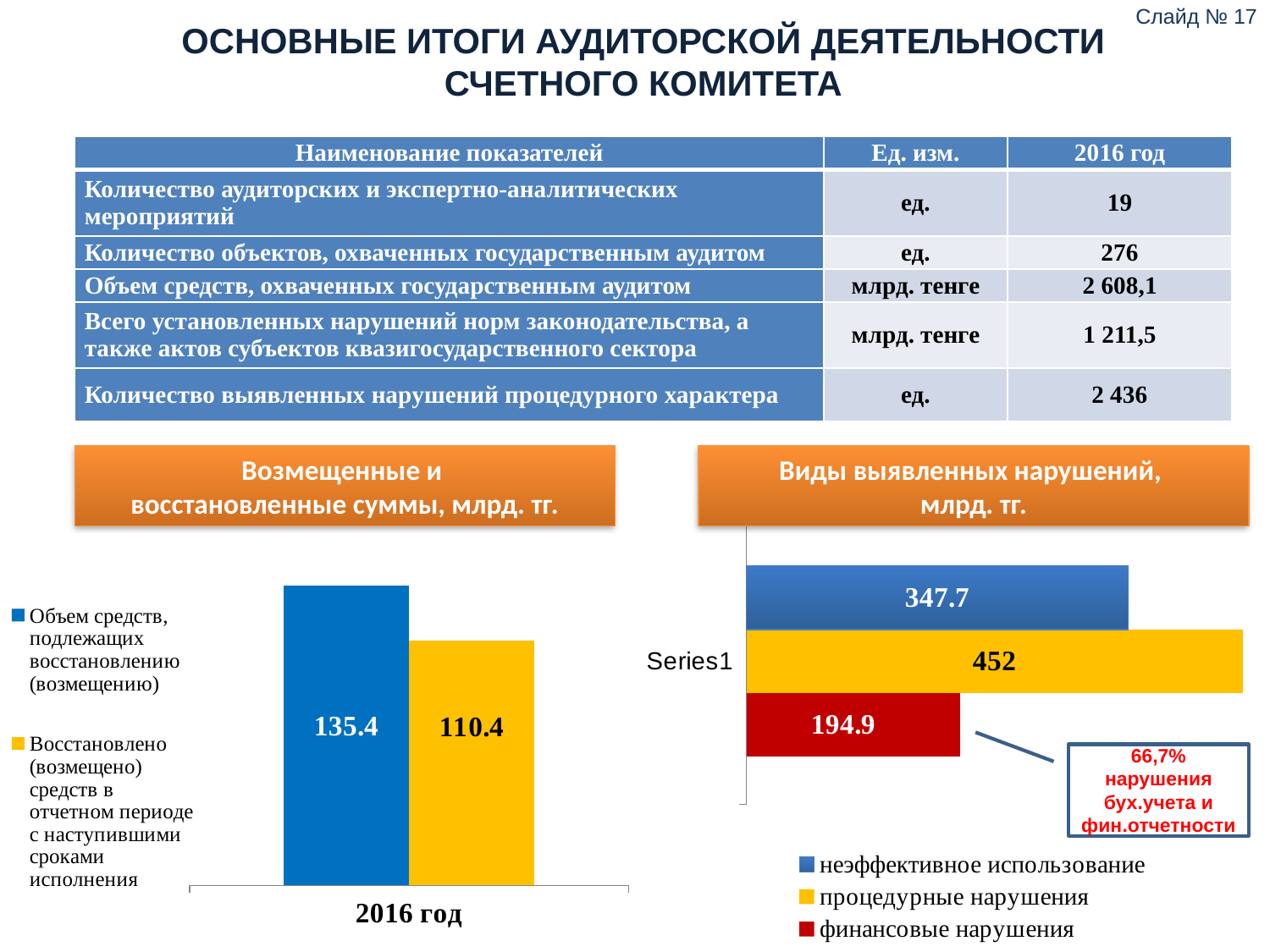
In the chart 'Возмещенные и восстановленные суммы, млрд. тг.', which series has the larger value? Объем средств, подлежащих восстановлению (возмещению) In the chart 'Возмещенные и восстановленные суммы, млрд. тг.', how many series does the legend list? 2 In the chart 'Виды выявленных нарушений, млрд. тг.', what is the value for 'неэффективное использование'? 347.7 In the chart 'Возмещенные и восстановленные суммы, млрд. тг.', what is the value for 'Восстановлено (возмещено) средств в отчетном периоде с наступившими сроками исполнения'? 110.4 In the chart 'Виды выявленных нарушений, млрд. тг.', what is the value for 'финансовые нарушения'? 194.9 In the chart 'Возмещенные и восстановленные суммы, млрд. тг.', what is the difference between the two plotted values? 25 What kind of chart is 'Виды выявленных нарушений, млрд. тг.'? bar chart In the chart 'Возмещенные и восстановленные суммы, млрд. тг.', what is the category label on the x axis? 2016 год In the chart 'Виды выявленных нарушений, млрд. тг.', which series has the lowest value? финансовые нарушения In the chart 'Виды выявленных нарушений, млрд. тг.', what is the value for 'процедурные нарушения'? 452 In the chart 'Возмещенные и восстановленные суммы, млрд. тг.', what is the value for 'Объем средств, подлежащих восстановлению (возмещению)'? 135.4 In the chart 'Виды выявленных нарушений, млрд. тг.', which series has the highest value? процедурные нарушения